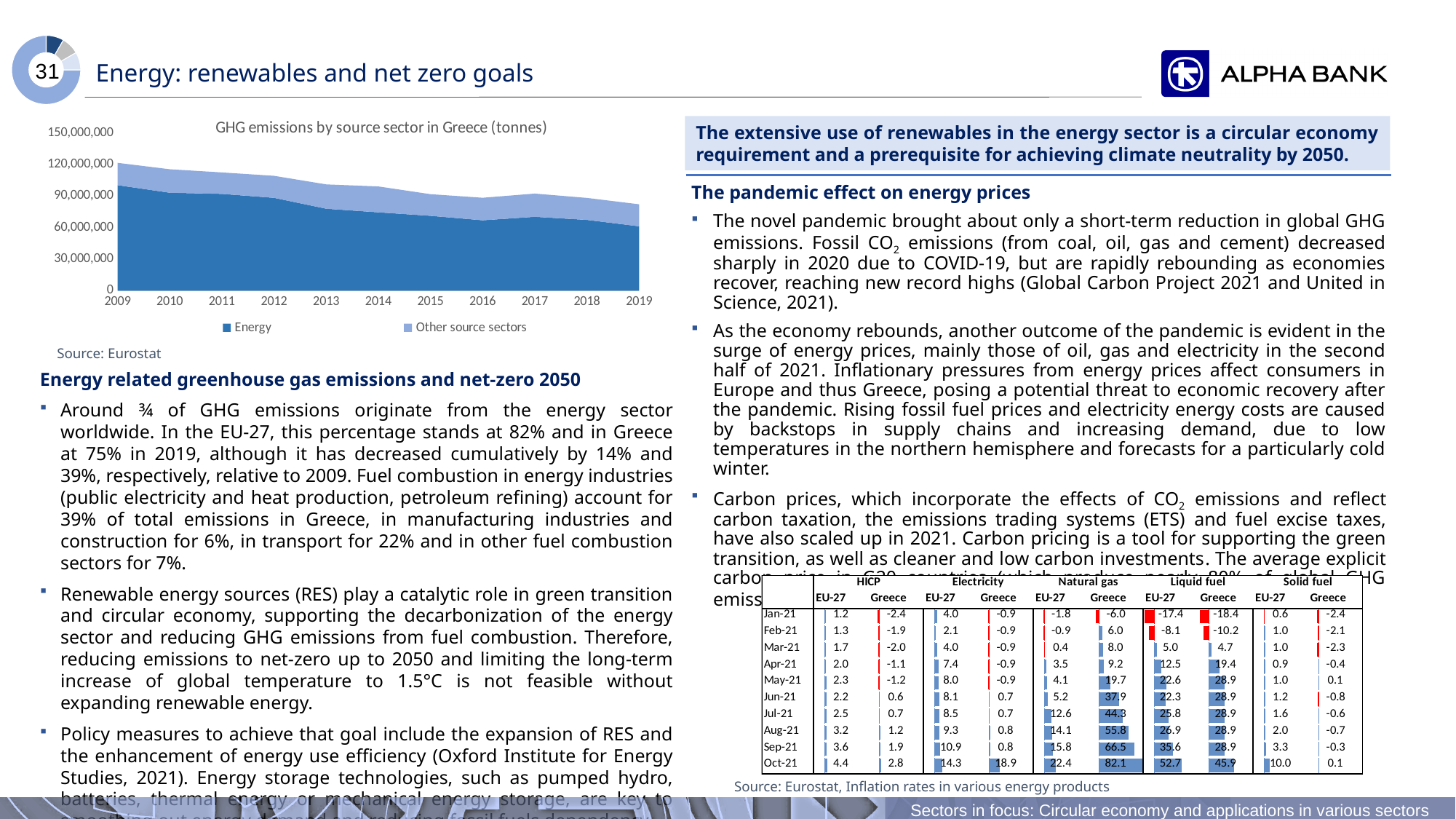
In the inflation rates table at the bottom right, what is the Natural gas value for Greece in Oct-21? 82.1 In the GHG emissions chart, which year has the highest Energy value? 2009 In the GHG emissions chart, is the Energy value for 2019 greater or less than 90,000,000? less What are the two legend entries of the GHG emissions chart? Energy; Other source sectors In the GHG emissions chart, is the total of Energy and Other source sectors in 2019 greater or less than 90,000,000? less In the GHG emissions chart, does the Energy series rise or fall from 2009 to 2019? Fall In the GHG emissions chart, is the Energy value larger in 2009 or in 2019? 2009 What kind of chart is 'GHG emissions by source sector in Greece (tonnes)'? Stacked area chart How many years are shown on the x axis of the GHG emissions chart? 11 In the GHG emissions chart, is the Energy value for 2009 greater or less than 90,000,000? greater How many series does the legend of the GHG emissions chart list? 2 What source is cited below the GHG emissions chart? Eurostat